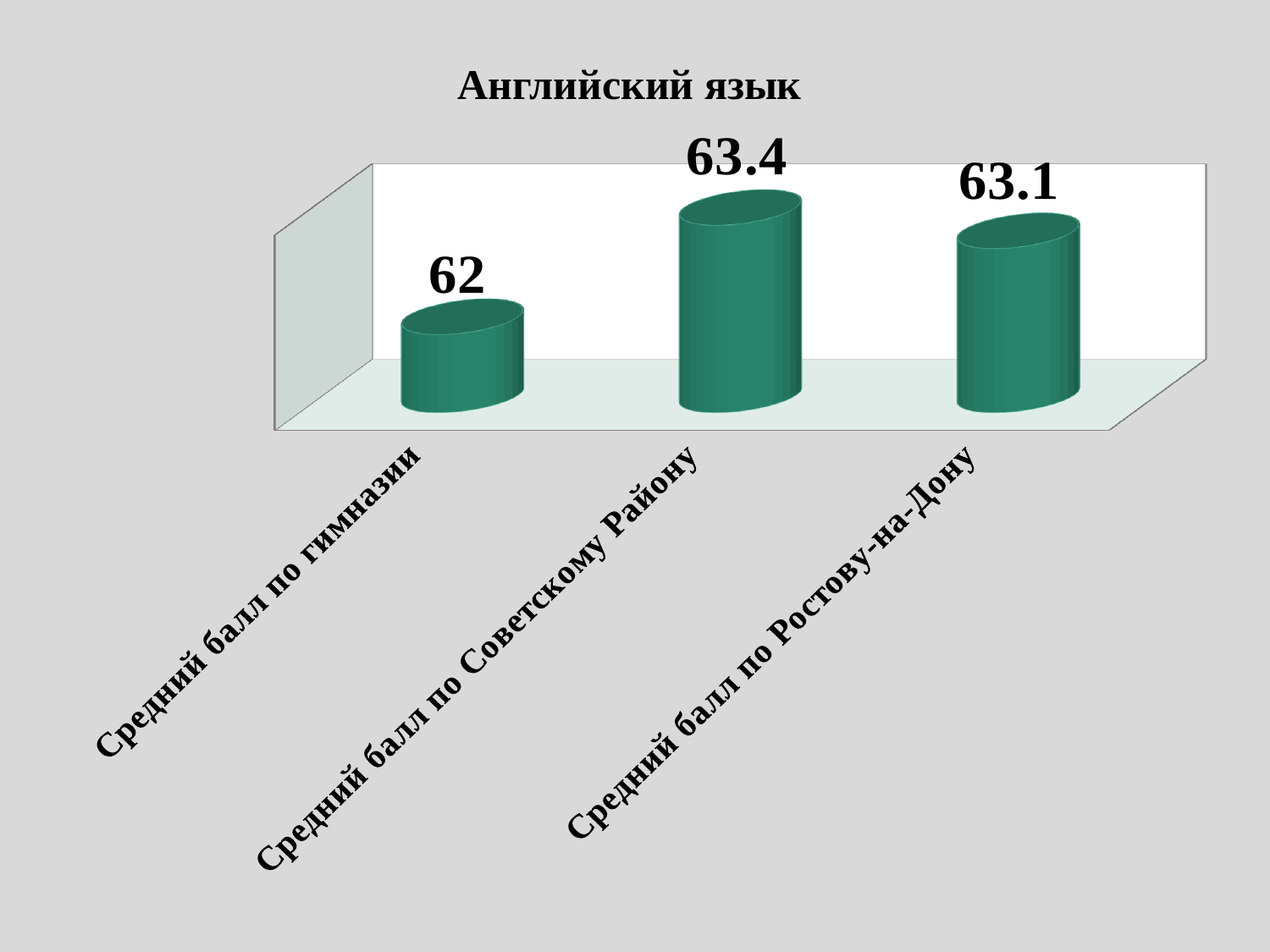
What is the difference between the value for Средний балл по Ростову-на-Дону and the value for Средний балл по гимназии? 1.1 What kind of chart is shown on the slide? Bar chart What is the value for Средний балл по гимназии? 62 What is the difference between the value for Средний балл по Советскому Району and the value for Средний балл по Ростову-на-Дону? 0.3 How many categories are shown in the chart? 3 What is the value for Средний балл по Ростову-на-Дону? 63.1 Which is larger: the value for Средний балл по Советскому Району or the value for Средний балл по Ростову-на-Дону? Средний балл по Советскому Району What is the value for Средний балл по Советскому Району? 63.4 What is the difference between the value for Средний балл по Советскому Району and the value for Средний балл по гимназии? 1.4 Which category has the lowest value? Средний балл по гимназии What is the title of the chart? Английский язык Which category has the highest value? Средний балл по Советскому Району